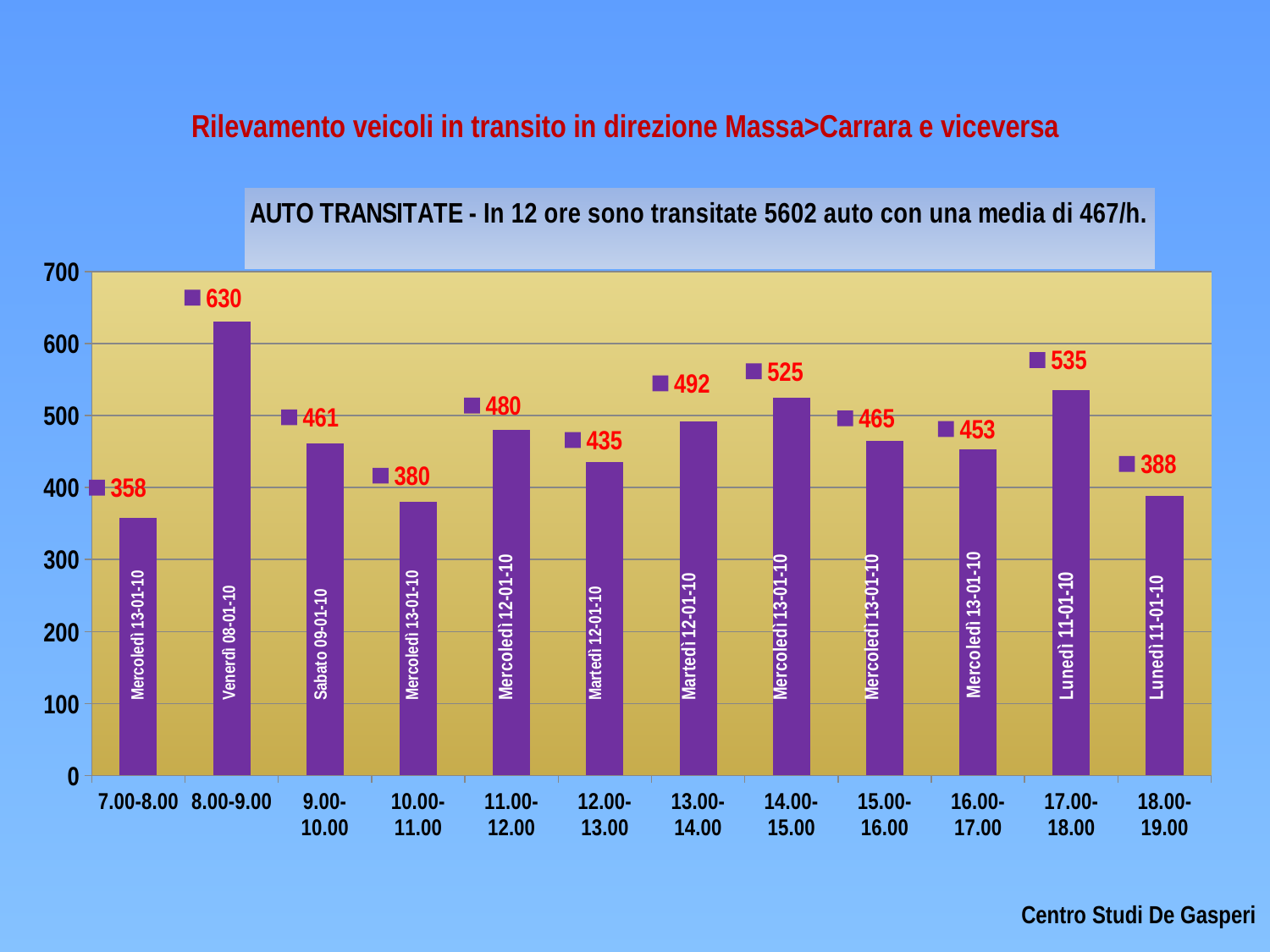
What is the difference between the values for 17.00-18.00 and 16.00-17.00? 82 What kind of chart is shown on the slide? bar chart Which is larger, the value for 14.00-15.00 or the value for 15.00-16.00? 14.00-15.00 What is the value for the 13.00-14.00 time slot? 492 How many time slots are shown on the x axis? 12 According to the chart's subtitle, how many cars passed in 12 hours? 5602 Which time slot has the lowest value? 7.00-8.00 What is the difference between the values for 8.00-9.00 and 7.00-8.00? 272 Do the values rise or fall from 9.00-10.00 to 10.00-11.00? fall Which time slot has the highest value? 8.00-9.00 What is the value for the 8.00-9.00 time slot? 630 What is the value for the 18.00-19.00 time slot? 388